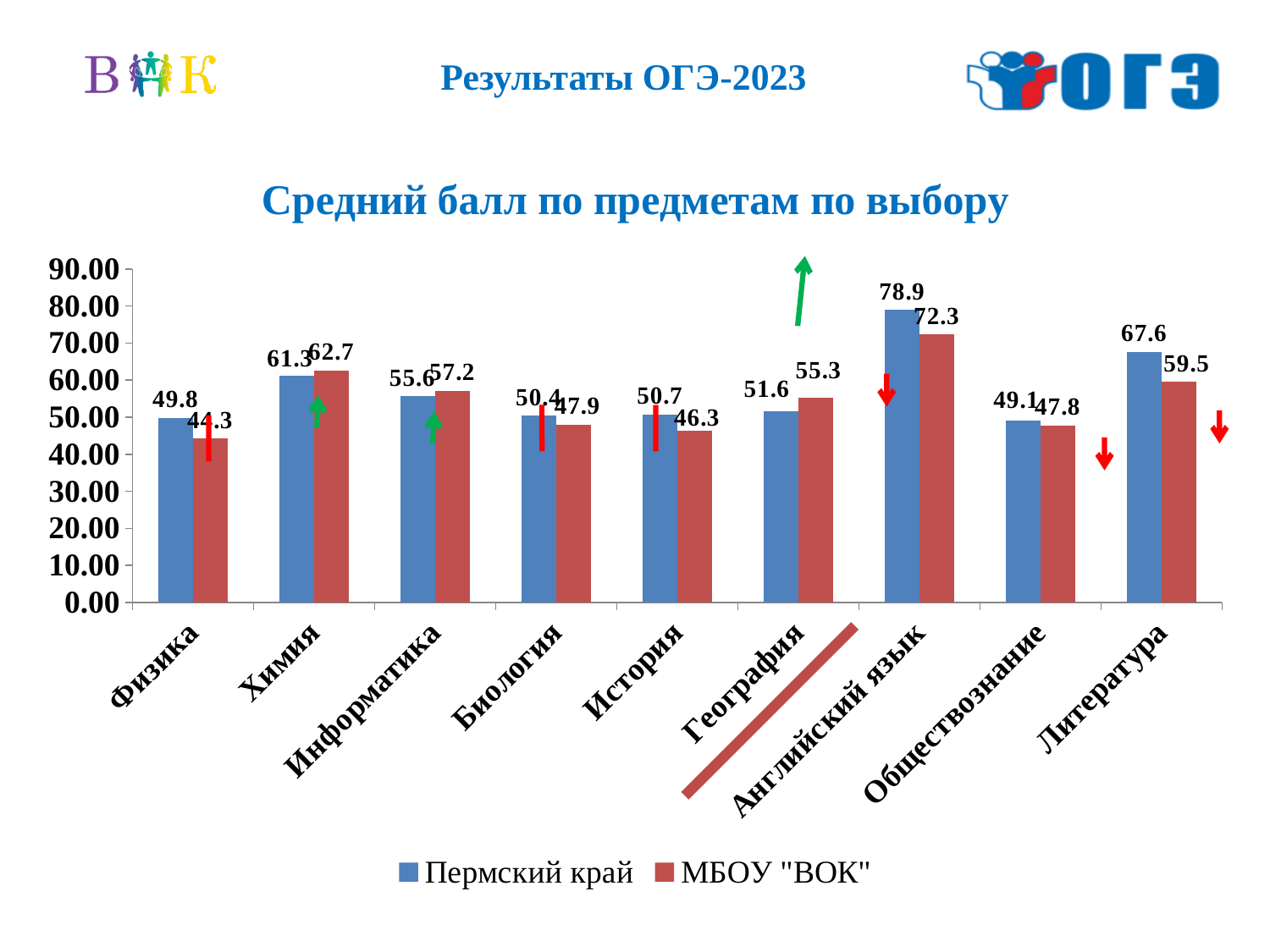
How many series does the legend list? 2 What is the value for Пермский край in Физика? 49.8 What is the difference between Пермский край and МБОУ "ВОК" in Литература? 8.1 What kind of chart is shown? bar chart Which subject has the highest value for Пермский край? Английский язык Which subject has the lowest value for МБОУ "ВОК"? Физика What is the value for МБОУ "ВОК" in Химия? 62.7 What is the title of the chart? Средний балл по предметам по выбору Which is larger in География: Пермский край or МБОУ "ВОК"? МБОУ "ВОК" How many subjects are shown on the x axis? 9 What is the value for МБОУ "ВОК" in Английский язык? 72.3 Is the value for Пермский край in Английский язык greater or less than 70.00? greater